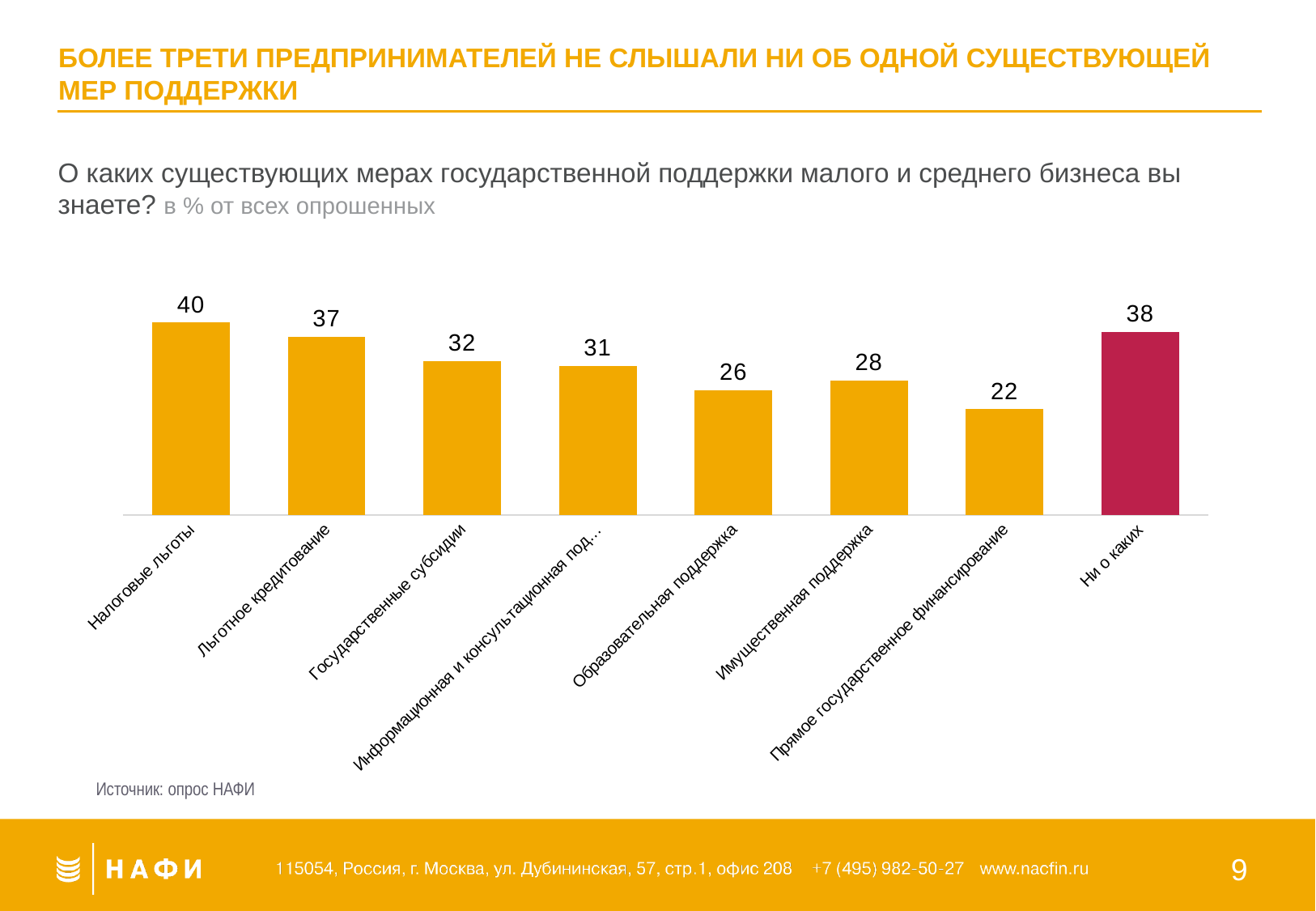
What kind of chart is shown on the slide? bar chart What is the difference between the values for Налоговые льготы and Ни о каких? 2 What is the value for Прямое государственное финансирование? 22 Which category has the highest value? Налоговые льготы What is the value for Ни о каких? 38 How many categories are shown in the chart? 8 What is the value for Налоговые льготы? 40 Which category has the lowest value? Прямое государственное финансирование What is the value for Льготное кредитование? 37 Which bar is shown in a different colour from the others? Ни о каких Which is larger, the value for Имущественная поддержка or the value for Образовательная поддержка? Имущественная поддержка What is the difference between the values for Государственные субсидии and Образовательная поддержка? 6